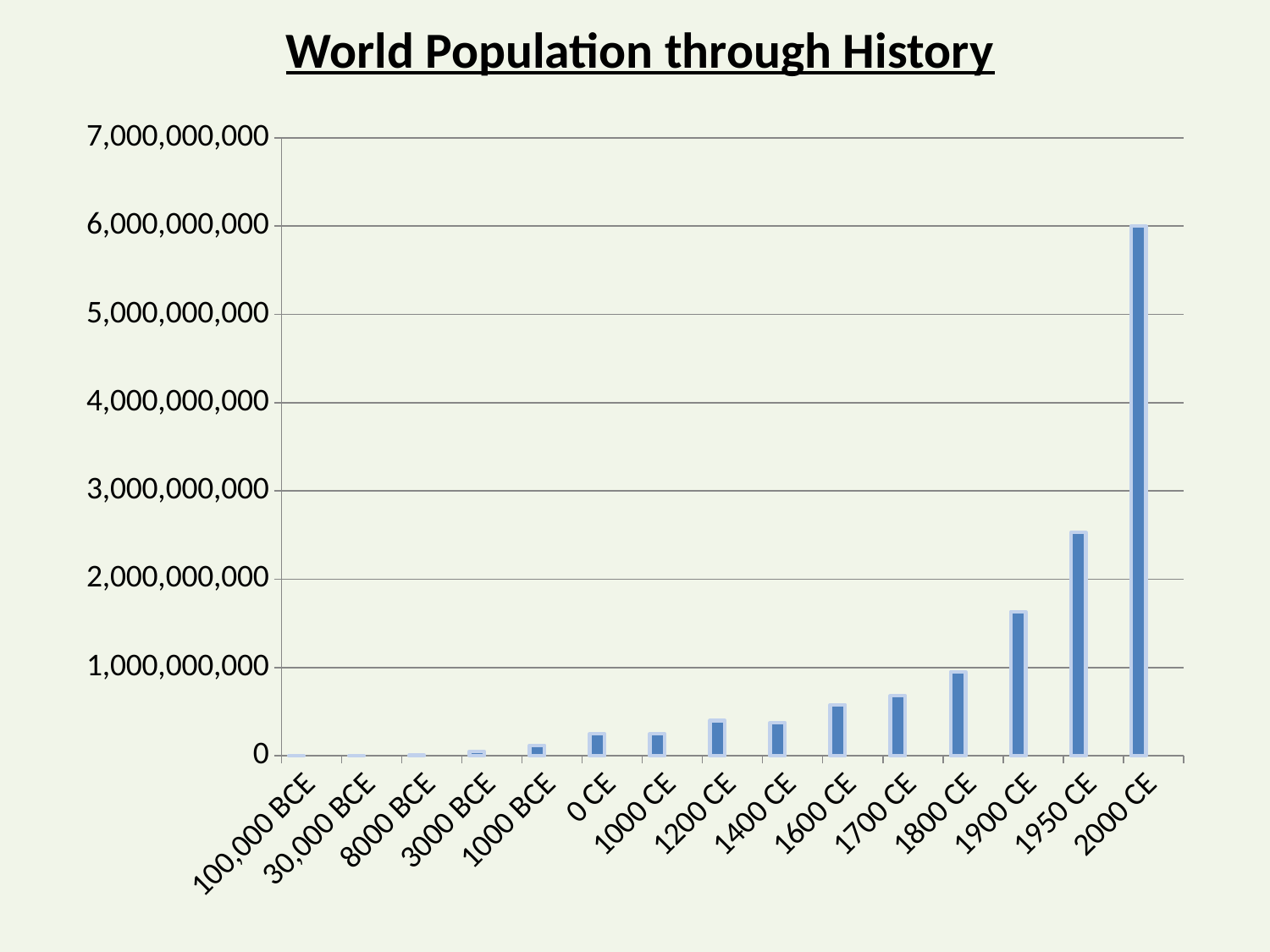
What is the title of the chart? World Population through History Is the value for 1900 CE greater or less than 1,000,000,000? greater Which category has the highest value? 2000 CE How many categories (time points) are shown on the x axis? 15 Do the values generally rise or fall moving from left to right along the x axis? rise What kind of chart is shown on the slide? bar chart Is the value for 1800 CE greater or less than 1,000,000,000? less Is the value for 1700 CE greater or less than 1,000,000,000? less Which is larger, the value for 1800 CE or the value for 1600 CE? 1800 CE Which is larger, the value for 1950 CE or the value for 1900 CE? 1950 CE